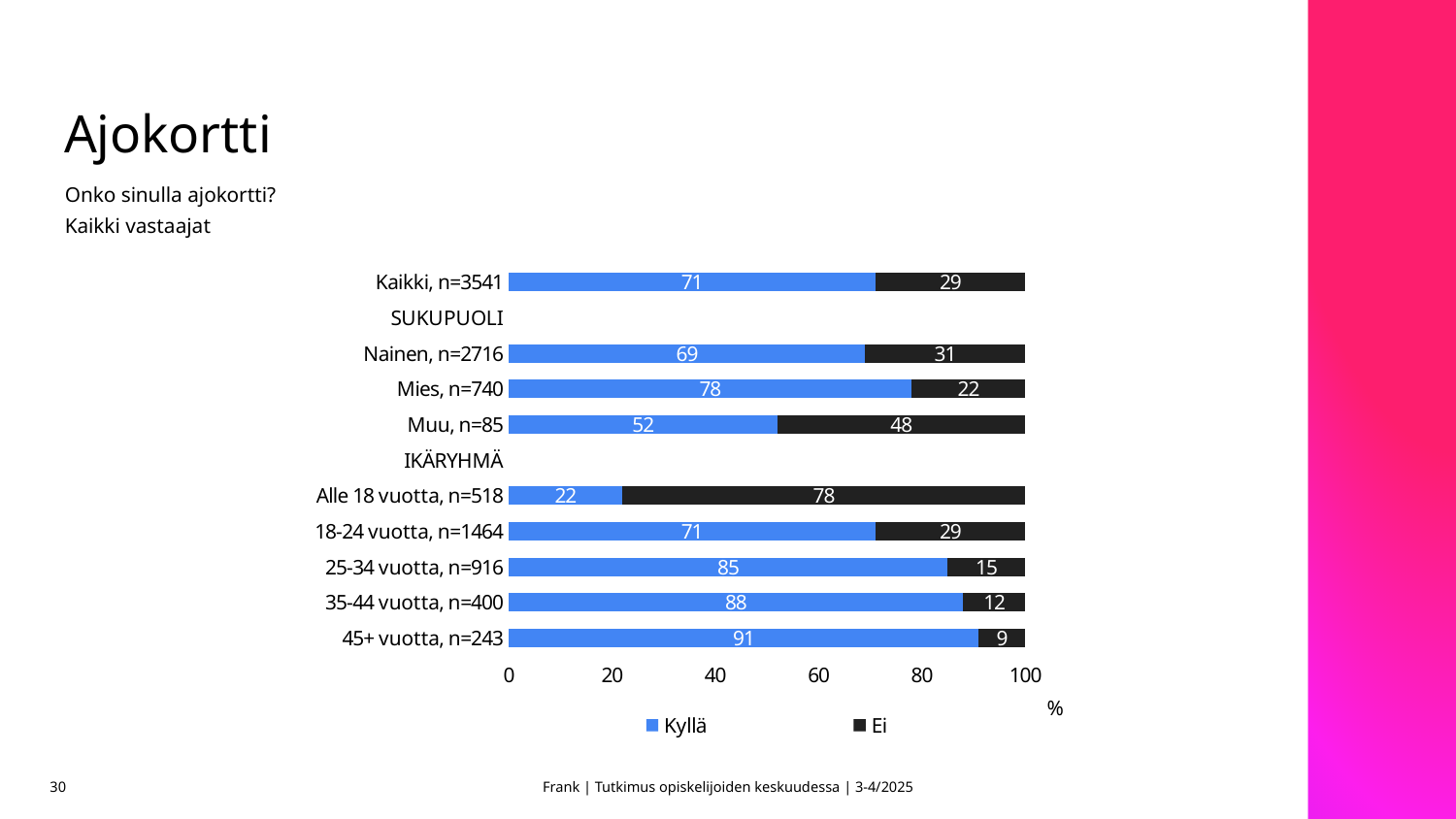
What is the Kyllä value for 35-44 vuotta, n=400? 88 What is the Kyllä value for Kaikki, n=3541? 71 Do the Kyllä values rise or fall as the age groups go from Alle 18 vuotta to 45+ vuotta? Rise Which has a larger Ei value, Nainen, n=2716 or Mies, n=740? Nainen, n=2716 What is the Ei value for Muu, n=85? 48 Which category has the highest Kyllä value? 45+ vuotta, n=243 What is the difference between the Kyllä values for Mies, n=740 and Nainen, n=2716? 9 What are the two legend entries of the chart? Kyllä and Ei What is the total of the stacked bar for 25-34 vuotta, n=916? 100 What kind of chart is shown on the slide? Stacked bar chart How many series does the legend list? 2 Which category has the lowest Kyllä value? Alle 18 vuotta, n=518